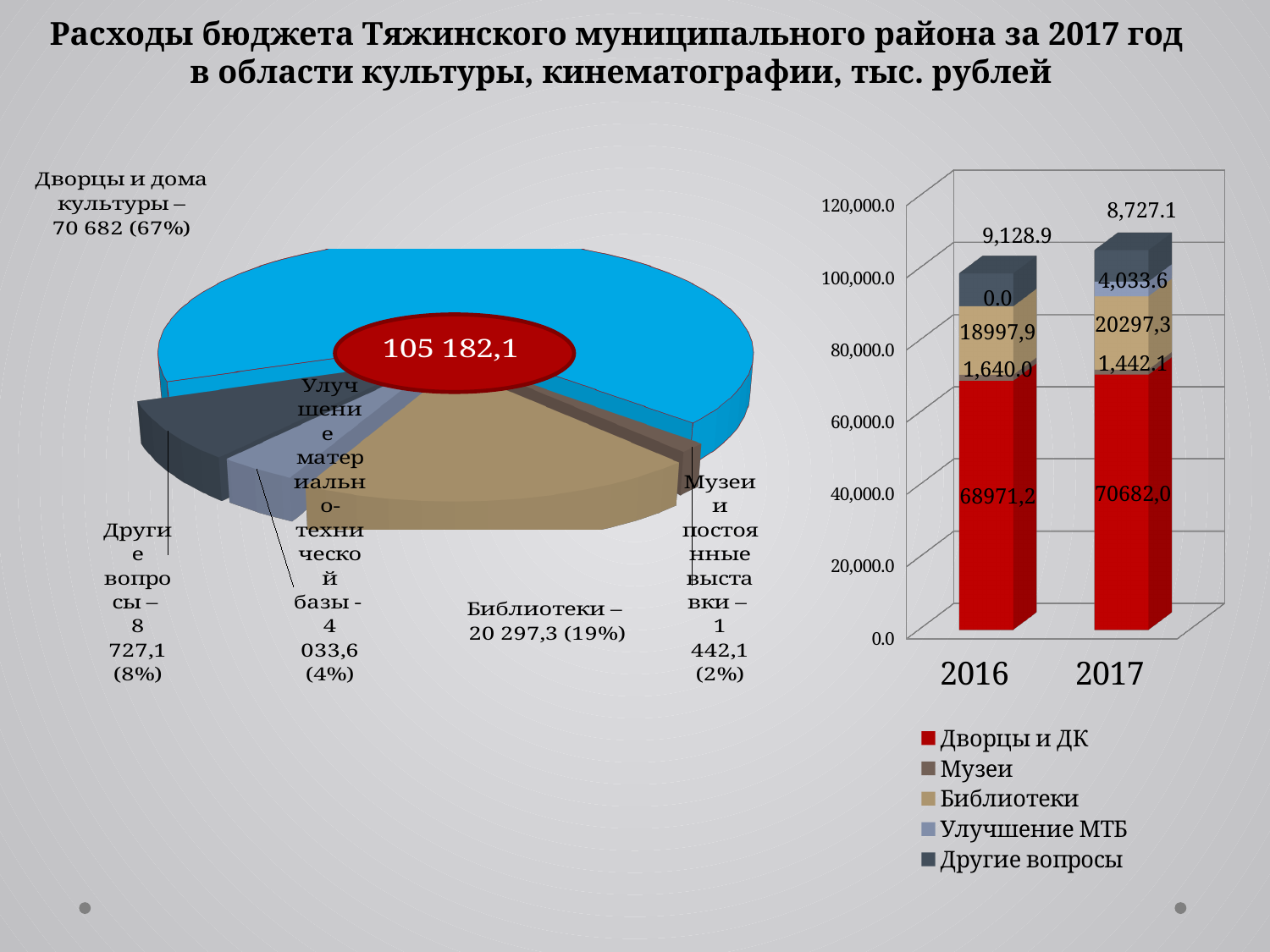
What kind of chart is the chart on the right of the slide? bar chart What kind of chart is the chart on the left of the slide? pie chart In the pie chart, what total value is printed in the centre? 105 182,1 In the pie chart, what value is shown for Другие вопросы? 8 727,1 In the bar chart, what is the value for Улучшение МТБ in 2017? 4,033.6 In the pie chart, which category has the smallest slice? Музеи и постоянные выставки In the pie chart, which category has the largest slice? Дворцы и дома культуры In the bar chart, what is the value for Библиотеки in 2016? 18997,9 In the bar chart, how many series does the legend list? 5 In the bar chart, by how much did the value for Дворцы и ДК change from 2016 to 2017? 1710,8 In the bar chart, is the value for Другие вопросы larger in 2016 or in 2017? 2016 In the pie chart, what share of the total do Библиотеки account for? 19%